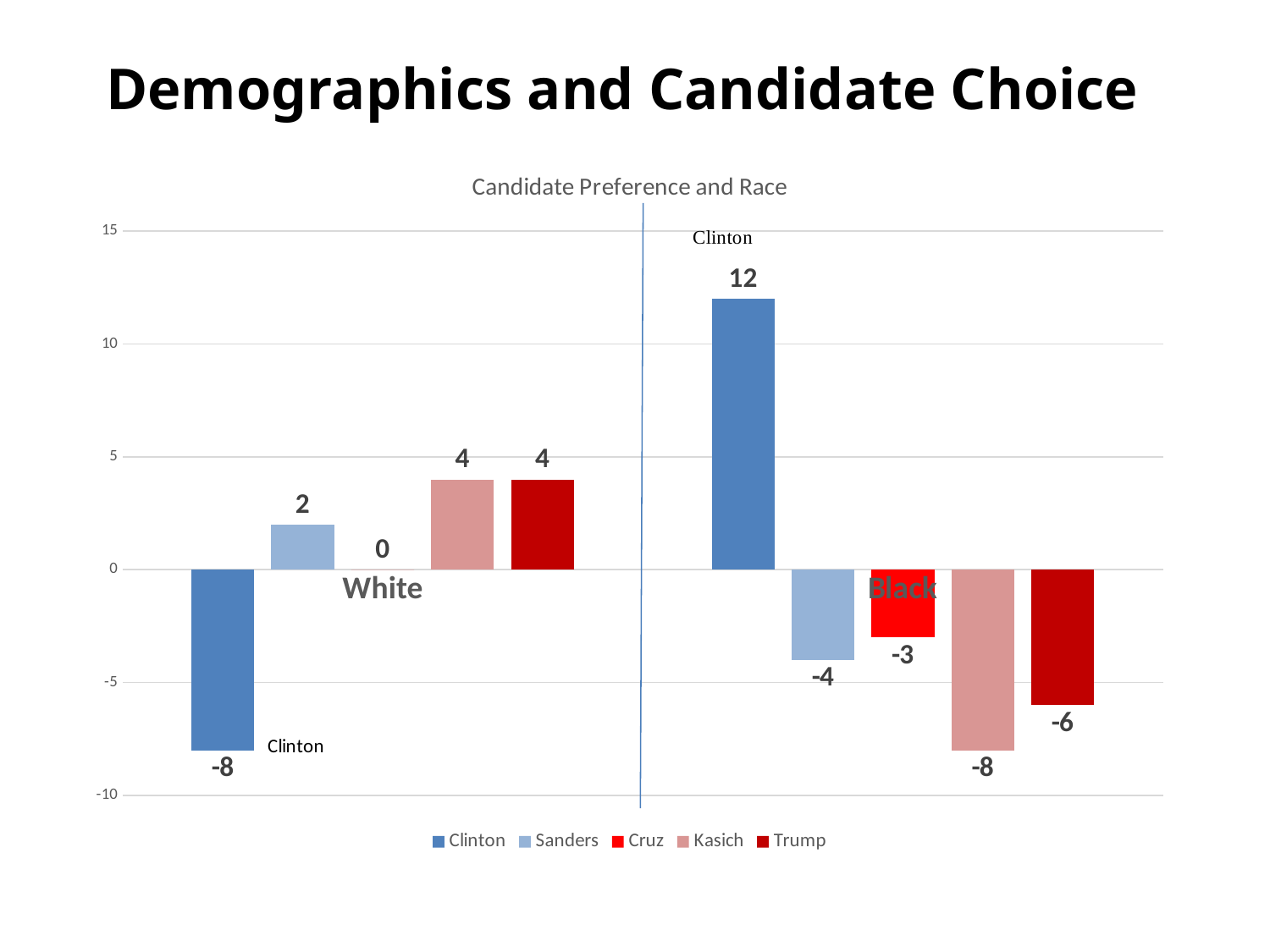
What is the value for Clinton in the White category? -8 Which candidate has the lowest value in the White category? Clinton What is the title of the chart? Candidate Preference and Race Which is larger, Trump's value in the White category or Trump's value in the Black category? White What is the value for Kasich in the Black category? -8 What is the value for Sanders in the Black category? -4 What is the value for Cruz in the White category? 0 How many series does the legend list? 5 What is the value for Clinton in the Black category? 12 What kind of chart is shown on the slide? Bar chart What is the difference between Clinton's value in the Black category and Clinton's value in the White category? 20 Which candidate has the highest value in the Black category? Clinton